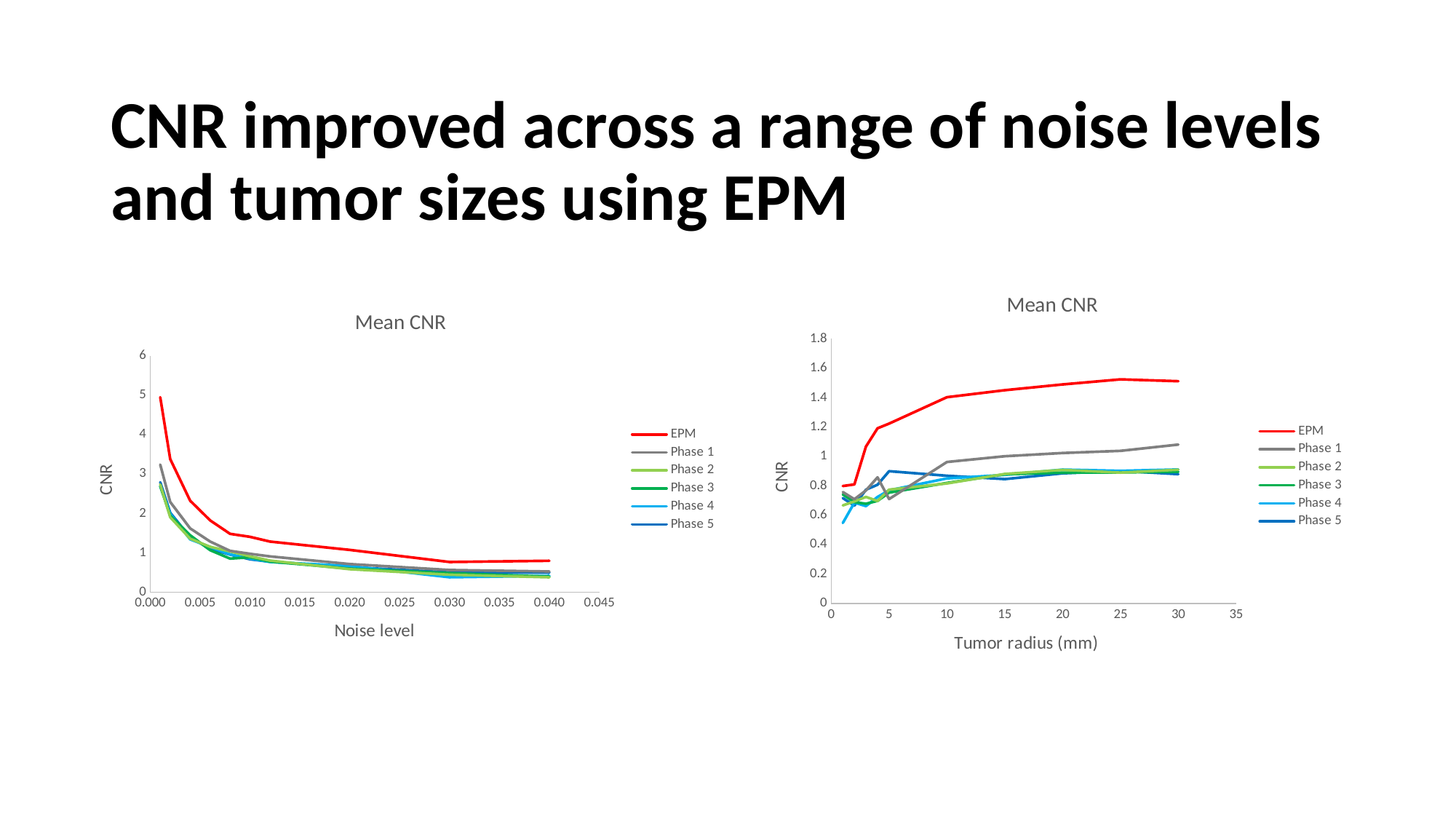
What is the x-axis title of the right chart? Tumor radius (mm) In the left chart (Noise level on the x axis), which series has the highest CNR across the noise levels? EPM In the right chart (Tumor radius on the x axis), at a tumor radius of 30 mm, which is larger: EPM or Phase 1? EPM In the left chart (Noise level on the x axis), does the EPM line rise or fall as noise level increases? Fall In the left chart (Noise level on the x axis), is the EPM value at noise level 0.040 greater or less than 1? less In the right chart (Tumor radius on the x axis), which series has the highest CNR at a tumor radius of 30 mm? EPM In the right chart (Tumor radius on the x axis), is the Phase 4 value at a tumor radius of 1 mm greater or less than 0.6? less In the right chart (Tumor radius on the x axis), is the EPM value at a tumor radius of 30 mm greater or less than 1.4? greater In the right chart (Tumor radius on the x axis), does the EPM line generally rise or fall as tumor radius increases? Rise How many series does the legend of the right chart (Tumor radius on the x axis) list? 6 What type of chart is the left chart titled "Mean CNR" with Noise level on the x axis? Line chart